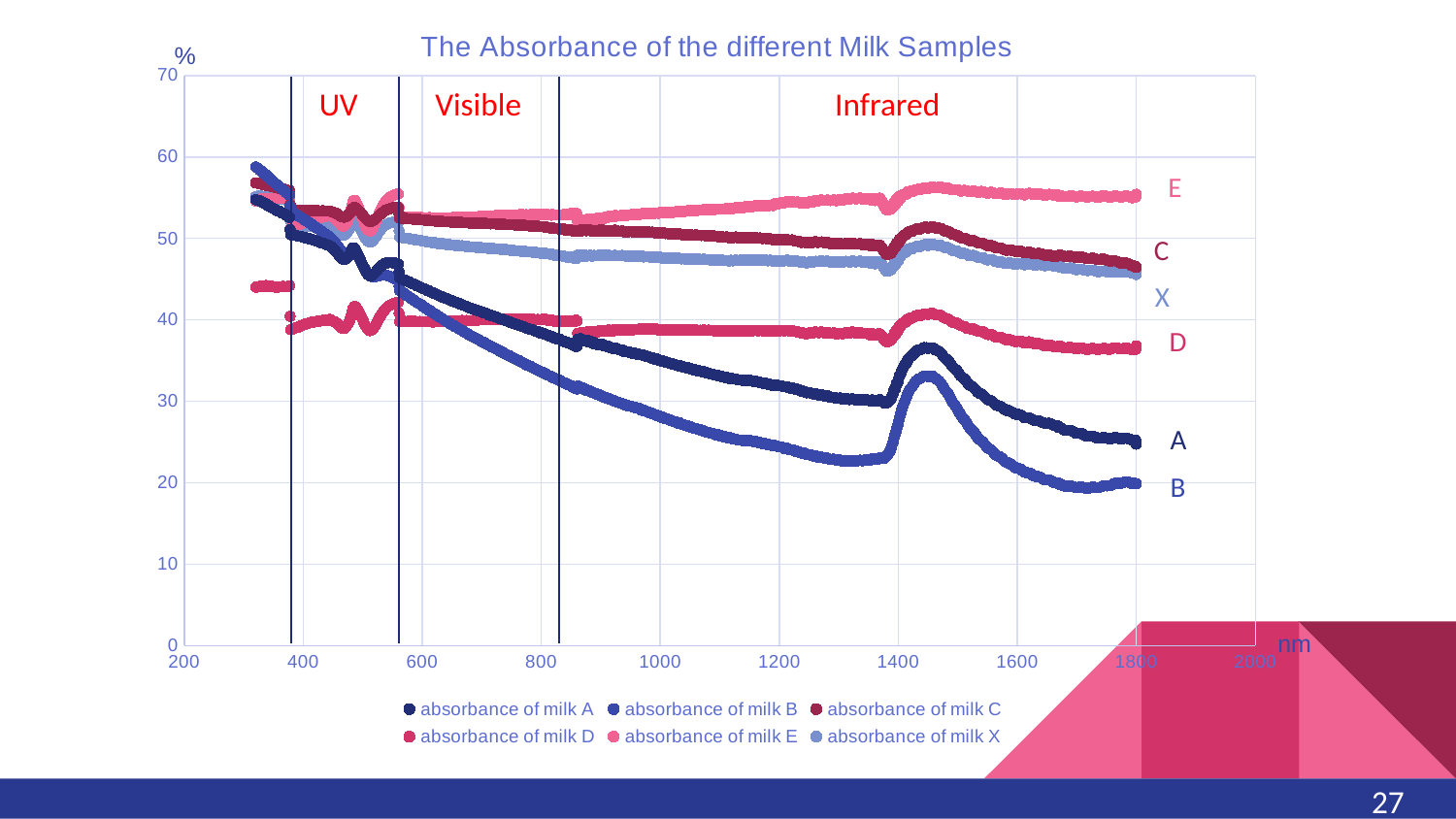
At 1000 nm, which has the larger absorbance, milk E or milk B? milk E Which milk sample has the highest absorbance at 1800 nm? milk E Is the absorbance of milk C at 1800 nm greater or less than 50? less What is the title of the chart? The Absorbance of the different Milk Samples How many series does the legend list? 6 Which three spectral regions are labelled on the chart? UV, Visible, Infrared What kind of chart is shown on the slide? scatter chart Is the absorbance of milk E at 1800 nm greater or less than 50? greater Does the absorbance of milk B rise or fall between 600 nm and 1400 nm? fall Is the absorbance of milk A at 1800 nm greater or less than 30? less Which milk sample has the lowest absorbance at 1800 nm? milk B